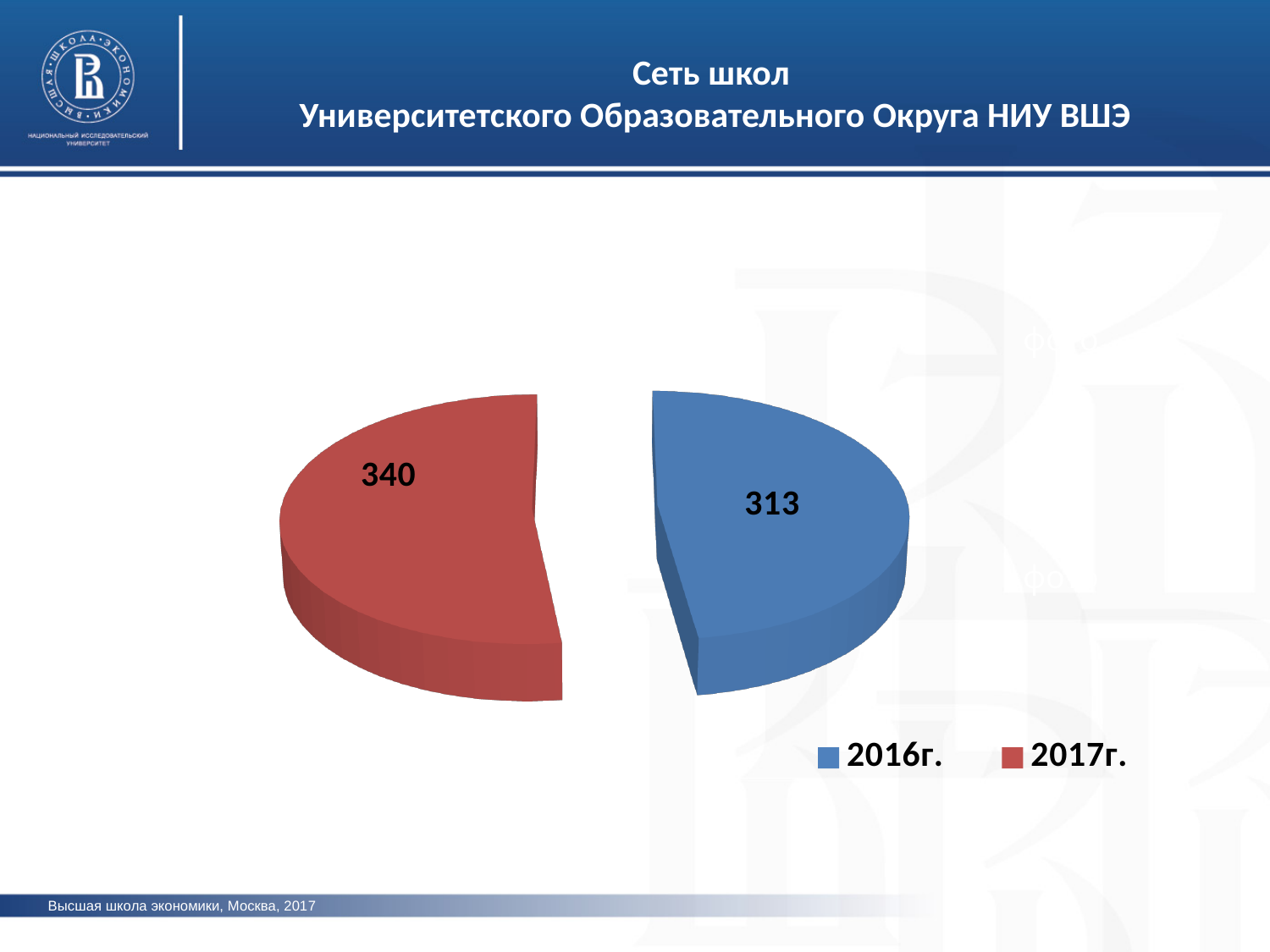
Which colour represents 2016г. in the pie chart? blue What is the value for 2016г. on the pie chart? 313 What is the difference between the values for 2017г. and 2016г.? 27 What is the value for 2017г. on the pie chart? 340 How many slices does the pie chart have? 2 What is the total of the two slices on the pie chart? 653 Is the value for 2017г. larger or smaller than the value for 2016г.? larger Which year has the smaller value on the pie chart? 2016г. How many entries does the legend list? 2 Which colour represents 2017г. in the pie chart? red What kind of chart is shown on the slide? pie chart Which year has the larger value on the pie chart? 2017г.